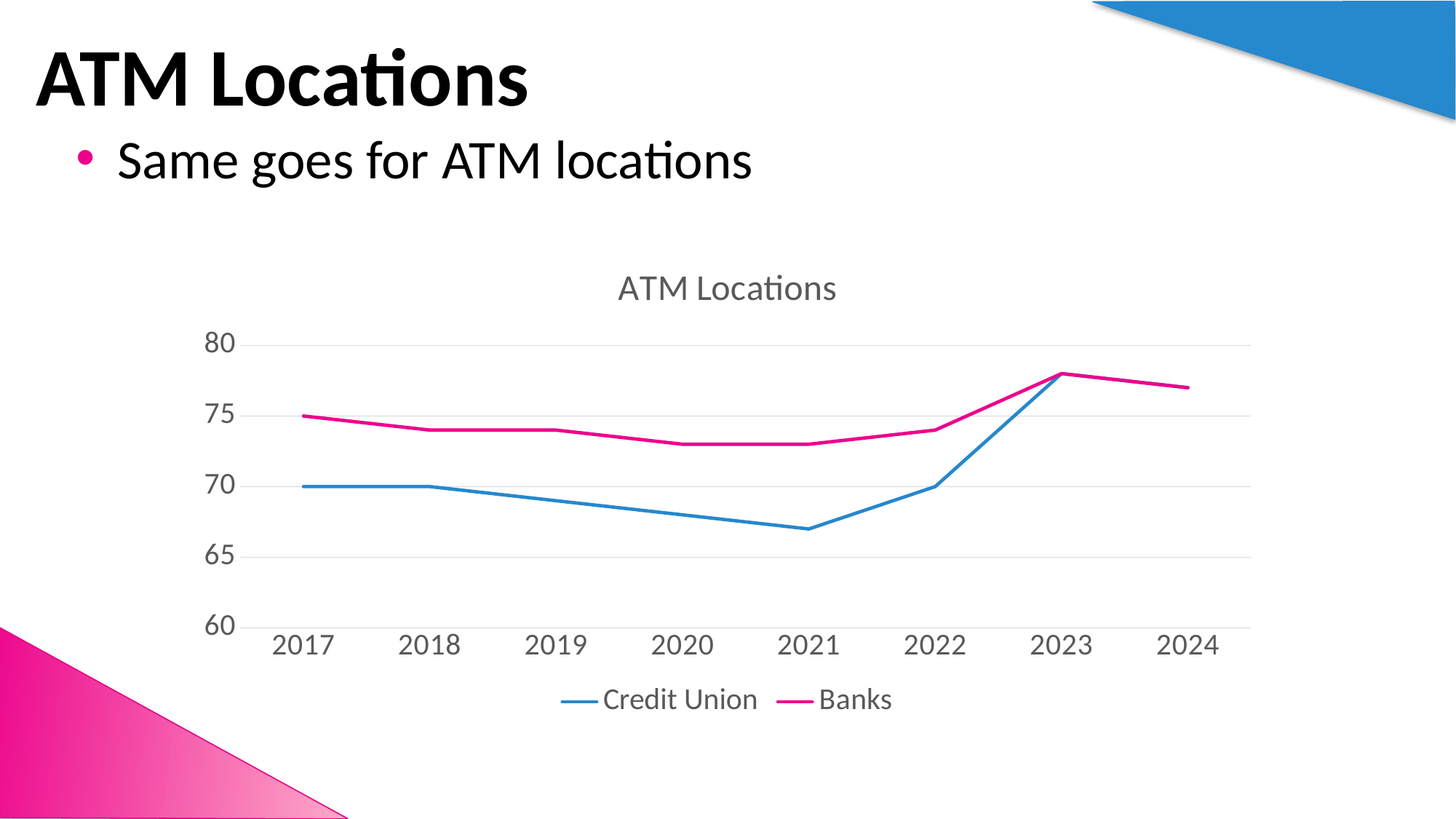
How many series does the legend list? 2 What is the Credit Union value for 2017? 70 In 2019, which series has the larger value, Credit Union or Banks? Banks In which year is the Credit Union value lowest? 2021 In which year is the Credit Union value highest? 2023 What is the Banks value for 2017? 75 What type of chart is shown on the slide? line chart How many years are shown on the x axis? 8 Does the Credit Union line rise or fall from 2018 to 2021? fall What is the Credit Union value for 2022? 70 Is the Credit Union value for 2021 greater or less than 70? less Is the Banks value for 2023 greater or less than 75? greater